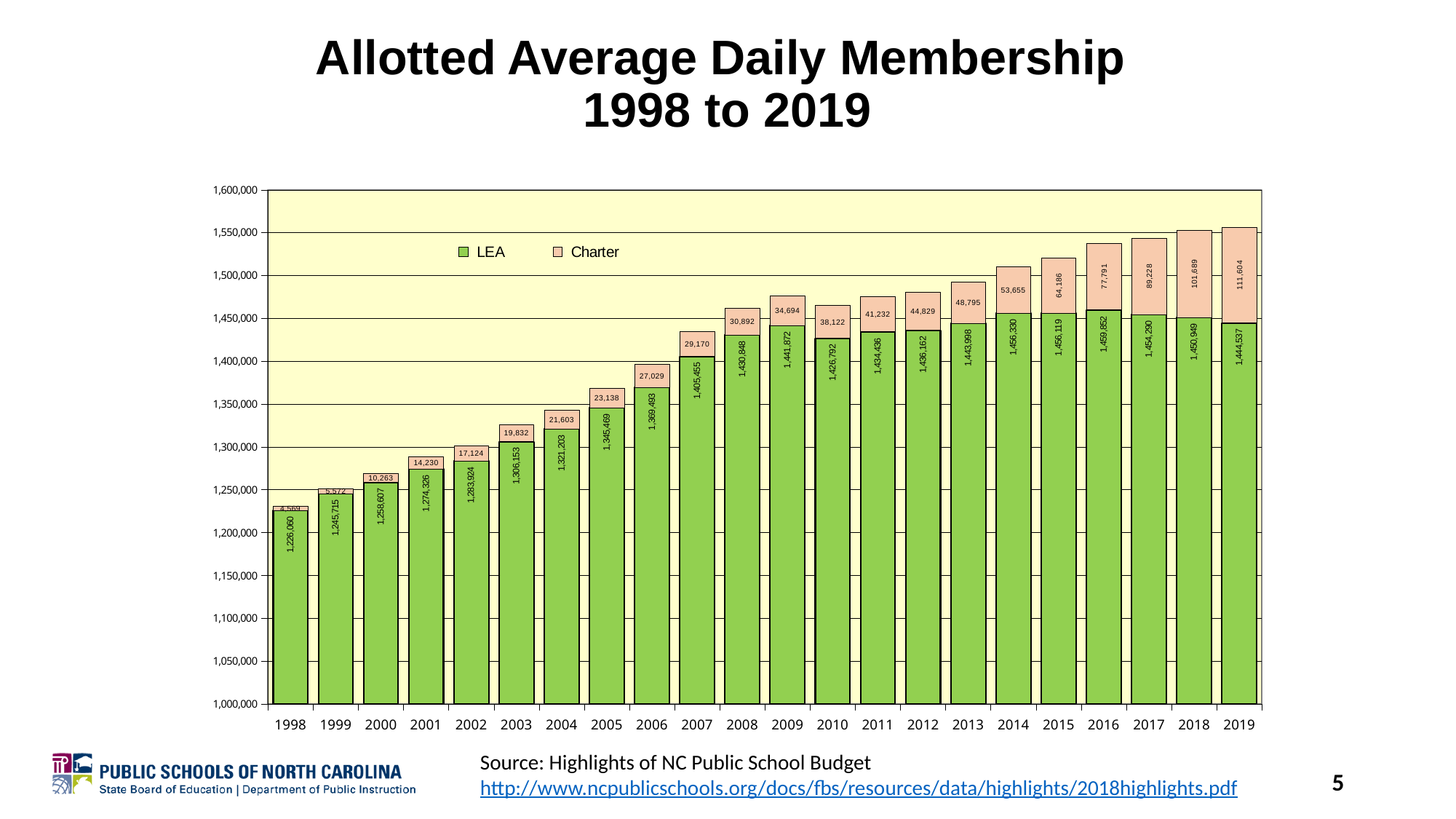
Which is larger, the LEA value for 2016 or for 2019? 2016 How many series does the legend list? 2 What is the difference between the LEA values for 2009 and 2010? 15,080 Is the total height of the 2007 bar greater or less than 1,450,000? less How many years are shown on the x axis? 22 What is the difference between the Charter values for 2019 and 2018? 9,915 Which year has the lowest LEA value? 1998 What is the total of the stacked bar for 2019? 1,556,141 What is the Charter value for 2019? 111,604 Which year has the highest LEA value? 2016 What is the LEA value for 2010? 1,426,792 Which year has the highest Charter value? 2019